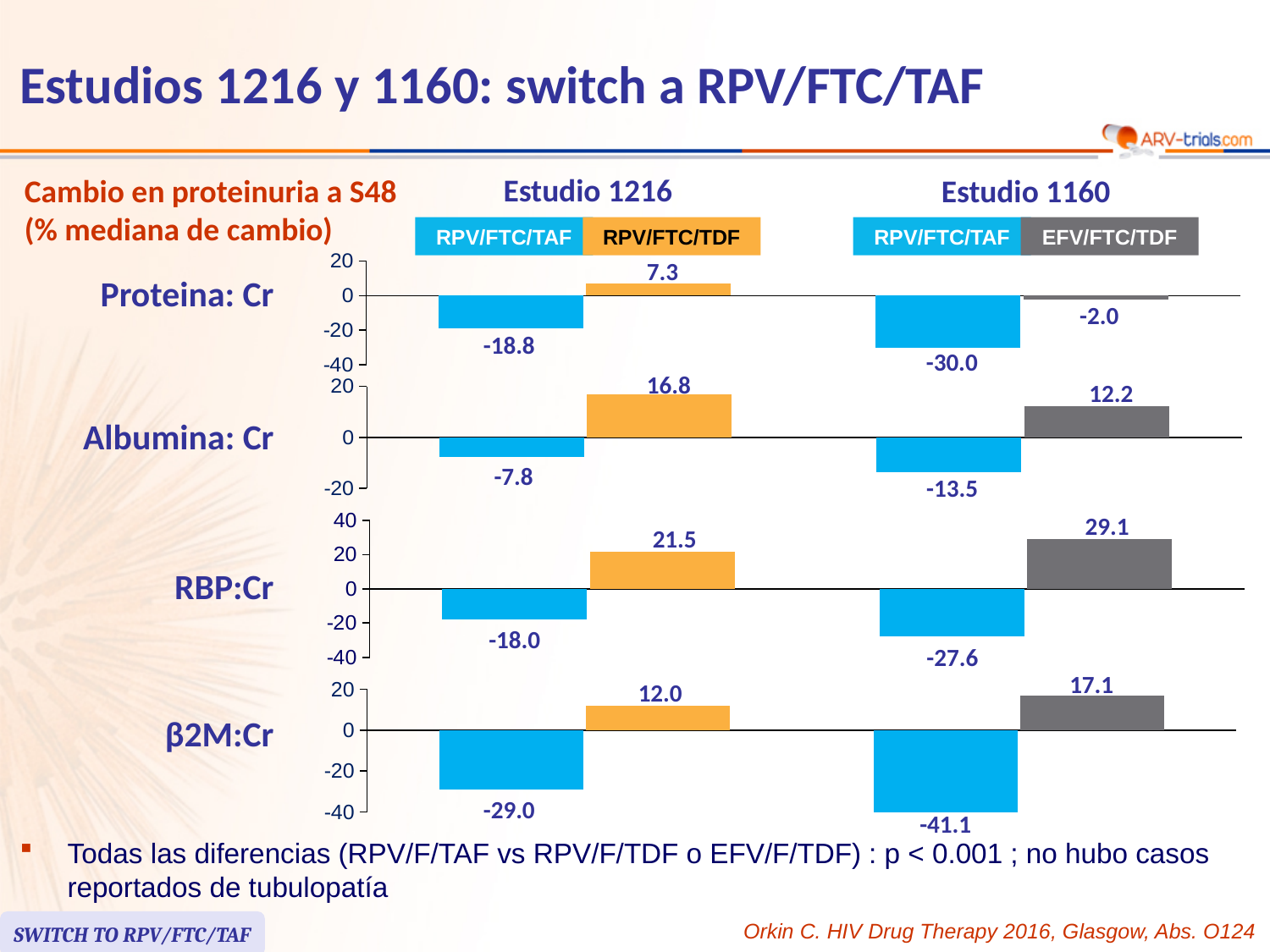
What kind of chart is used to show the change in proteinuria on this slide? Bar chart What colour are the RPV/FTC/TAF bars in the charts? Blue In the Albumina: Cr chart, which of the four bars shows the lowest value? RPV/FTC/TAF in Estudio 1160 (-13.5) In the Proteina: Cr chart, what is the value for RPV/FTC/TAF in Estudio 1216? -18.8 In the Albumina: Cr chart, what is the value for RPV/FTC/TDF in Estudio 1216? 16.8 In the Proteina: Cr chart, what is the value for EFV/FTC/TDF in Estudio 1160? -2.0 How many treatment arms are shown for Estudio 1160? 2 In the RBP:Cr chart, what is the value for RPV/FTC/TAF in Estudio 1160? -27.6 In the Proteina: Cr chart, which of the four bars shows the highest value? RPV/FTC/TDF in Estudio 1216 (7.3) In the β2M:Cr chart, what is the value for RPV/FTC/TAF in Estudio 1160? -41.1 In the β2M:Cr chart, what is the difference between the RPV/FTC/TDF value and the RPV/FTC/TAF value in Estudio 1216? 41.0 In the RBP:Cr chart, which arm has the higher value in Estudio 1160, RPV/FTC/TAF or EFV/FTC/TDF? EFV/FTC/TDF